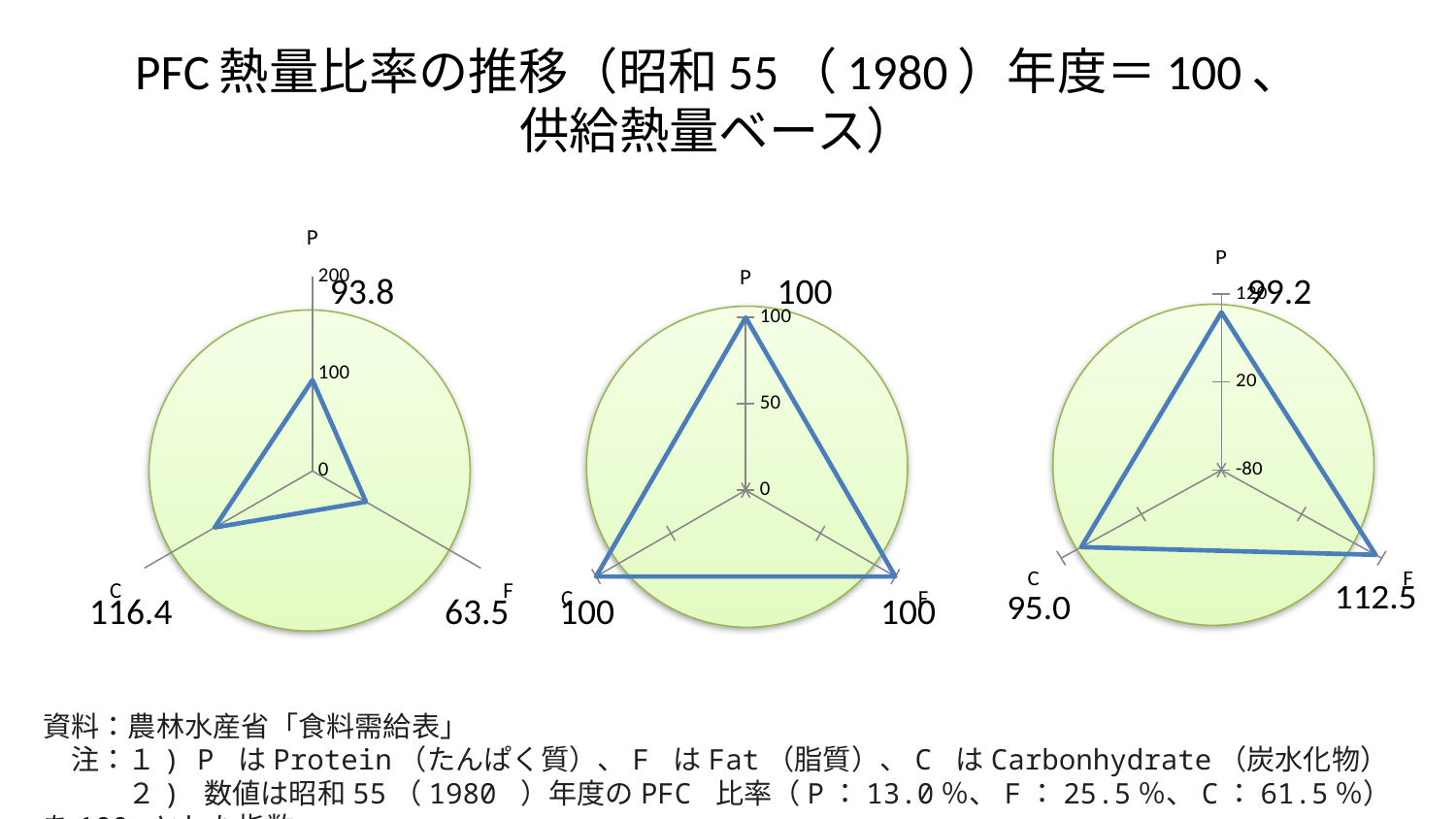
In the right chart, what is the value for C? 95.0 How many categories (axes) does each radar chart have? 3 In the left chart, what is the value for C? 116.4 In the left chart, which category has the lowest value? F In the left chart, which category has the highest value? C What kind of chart is each of the three charts on the slide? radar chart In the left chart, what is the difference between the values for C and F? 52.9 In the right chart, which is larger, the value for P or the value for C? P In the left chart, what is the value for F? 63.5 In the left chart, what is the value for P? 93.8 In the middle chart, what is the value for F? 100 In the right chart, what is the value for F? 112.5